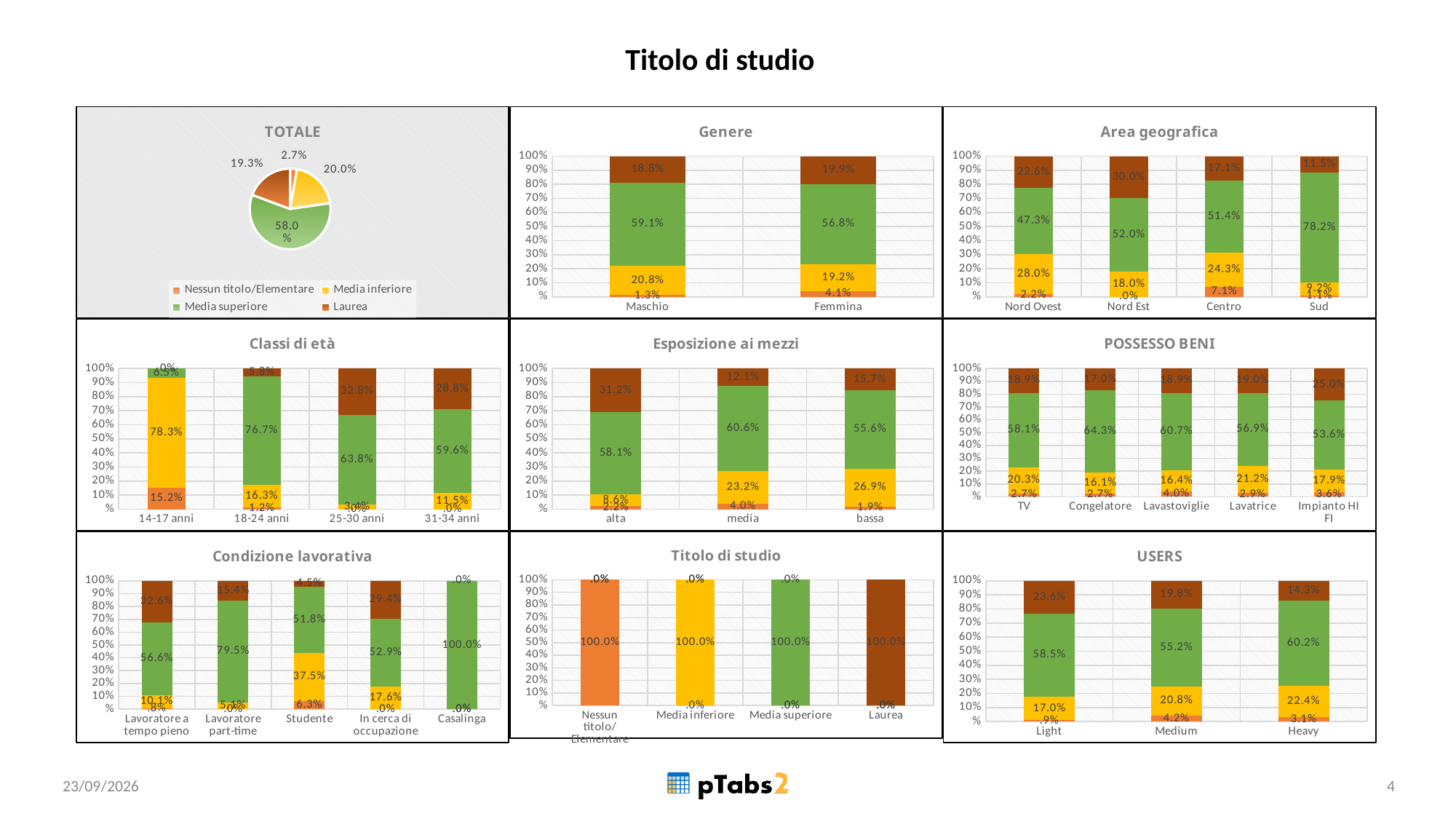
In the Classi di età chart, what is the Media inferiore value for 14-17 anni? 78.3% In the Area geografica chart, which region has the highest Media superiore value? Sud In the POSSESSO BENI chart, how many categories are shown on the x axis? 5 In the Esposizione ai mezzi chart, which category has the highest Laurea value? alta In the USERS chart, which is larger, the Laurea value for Light or for Heavy? Light In the Condizione lavorativa chart, what is the Media superiore value for Casalinga? 100.0% In the Genere chart, what is the Media superiore value for Maschio? 59.1% In the TOTALE pie chart, what share is shown for Media superiore? 58.0% In the Area geografica chart, what is the Laurea value for Nord Est? 30.0% How many series does the legend in the TOTALE chart list? 4 In the Genere chart, what is the difference between the Laurea values for Femmina and Maschio? 1.1% What kind of chart is the TOTALE chart? pie chart